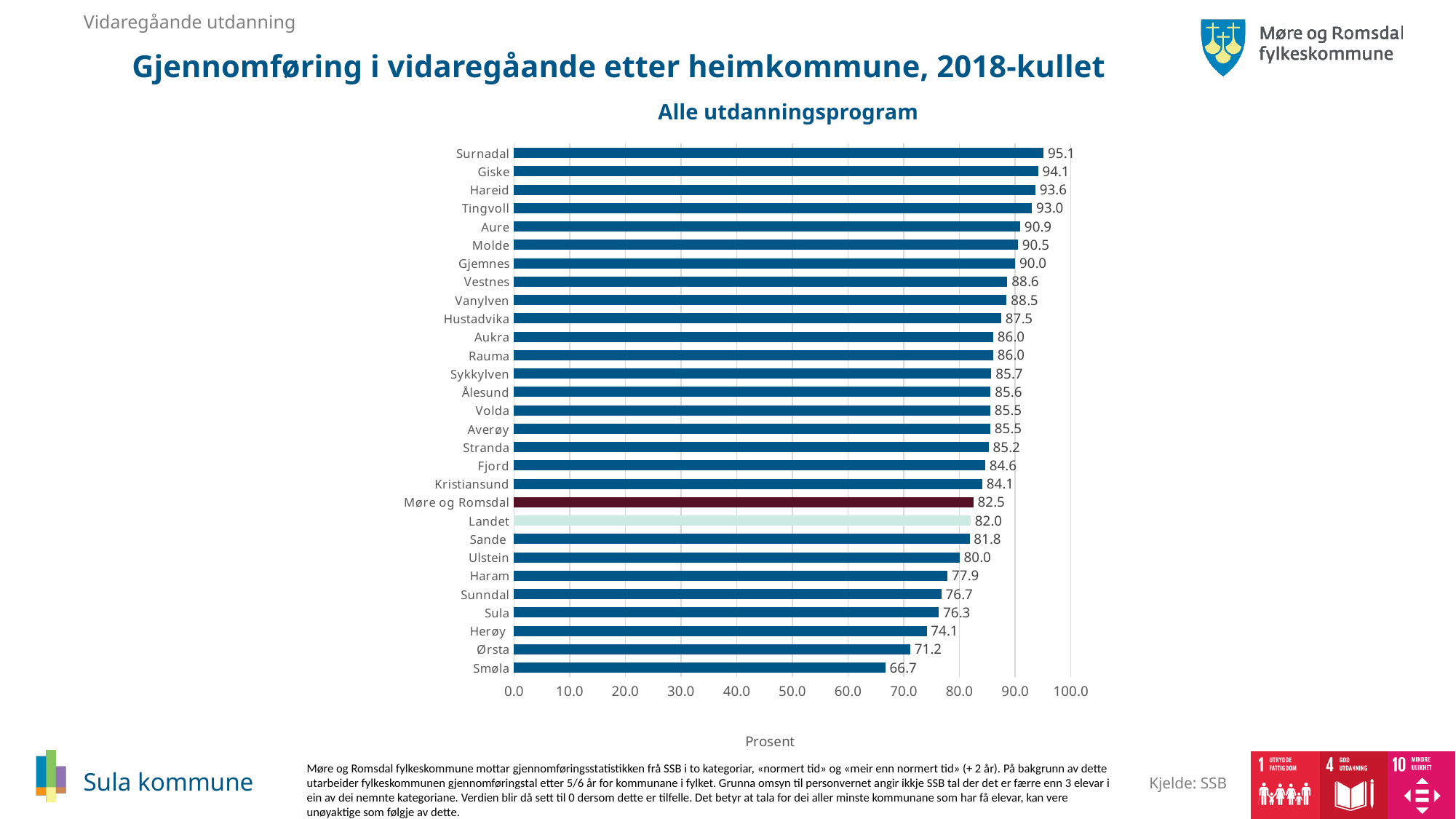
What is the value for Landet in the chart? 82.0 Which has a larger value, Molde or Ålesund? Molde What is the value for Møre og Romsdal in the chart? 82.5 What is the difference between the values for Sula and Møre og Romsdal? 6.2 What is the value for Sula in the chart? 76.3 Is the value for Ørsta greater or less than 80.0? less What kind of chart is shown on the slide? bar chart Which category has the lowest value in the chart? Smøla Which category has the highest value in the chart? Surnadal What is the title of the chart? Alle utdanningsprogram What is the difference between the values for Surnadal and Smøla? 28.4 How many categories are shown in the chart? 29